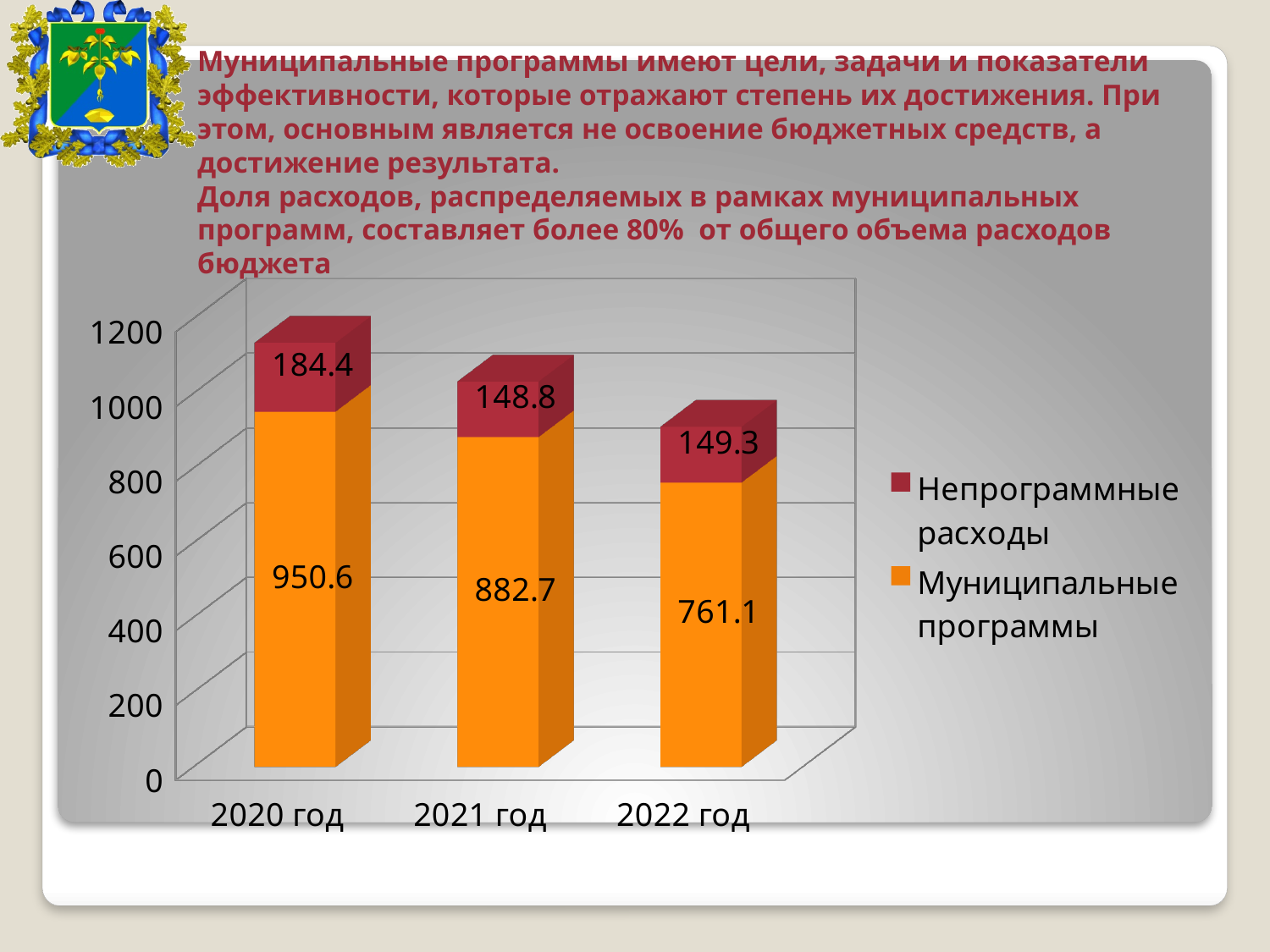
What is the value for Муниципальные программы in 2020 год? 950.6 What is the difference between the Непрограммные расходы values for 2020 год and 2021 год? 35.6 How many years are shown on the x axis? 3 What is the difference between the Муниципальные программы values for 2020 год and 2021 год? 67.9 What is the value for Муниципальные программы in 2021 год? 882.7 What is the total of the stacked bar for 2022 год? 910.4 In which year is the value for Муниципальные программы the highest? 2020 год What kind of chart is shown on the slide? Stacked bar chart How many series does the legend list? 2 What is the value for Непрограммные расходы in 2022 год? 149.3 In which year is the value for Муниципальные программы the lowest? 2022 год Which is larger: Непрограммные расходы in 2020 год or in 2021 год? 2020 год